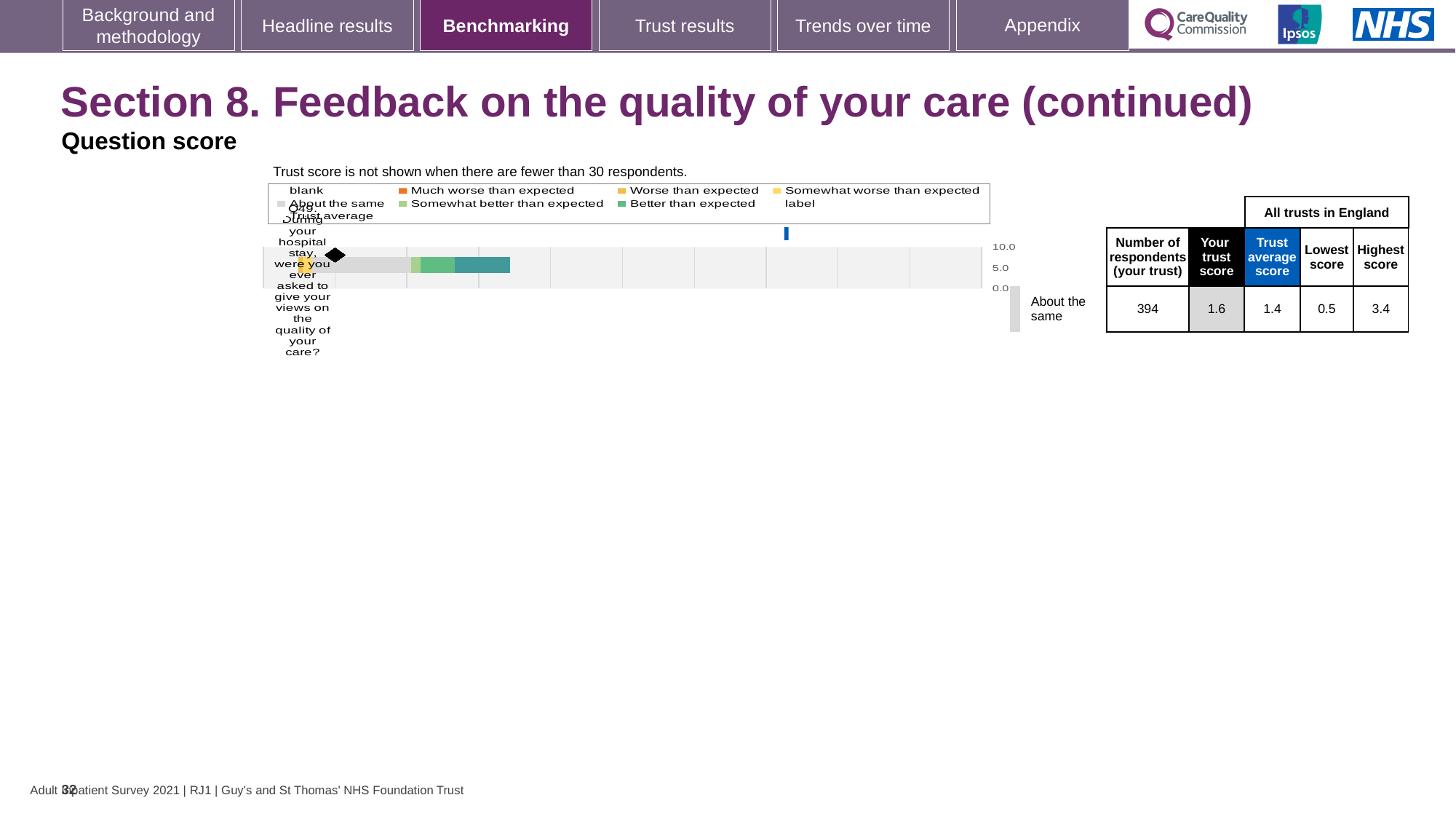
What kind of chart is used to show the Q49 benchmarking result on this slide? bar chart What is the highest score among all trusts in England for Q49? 3.4 What is the difference between the trust score and the trust average score for Q49? 0.2 What is the lowest score among all trusts in England for Q49? 0.5 Is the trust score for Q49 greater or less than 5.0 on the chart axis? less Which is larger for Q49: the trust's own score or the trust average score? the trust's own score What is the trust score for Q49 shown on this slide? 1.6 What benchmark category label is shown next to the Q49 chart? About the same What is the trust average score for Q49 shown on this slide? 1.4 How many respondents from the trust answered Q49? 394 What is the difference between the highest and lowest scores among all trusts in England for Q49? 2.9 Which question is plotted in the benchmarking chart on this slide? Q49. During your hospital stay, were you ever asked to give your views on the quality of your care?